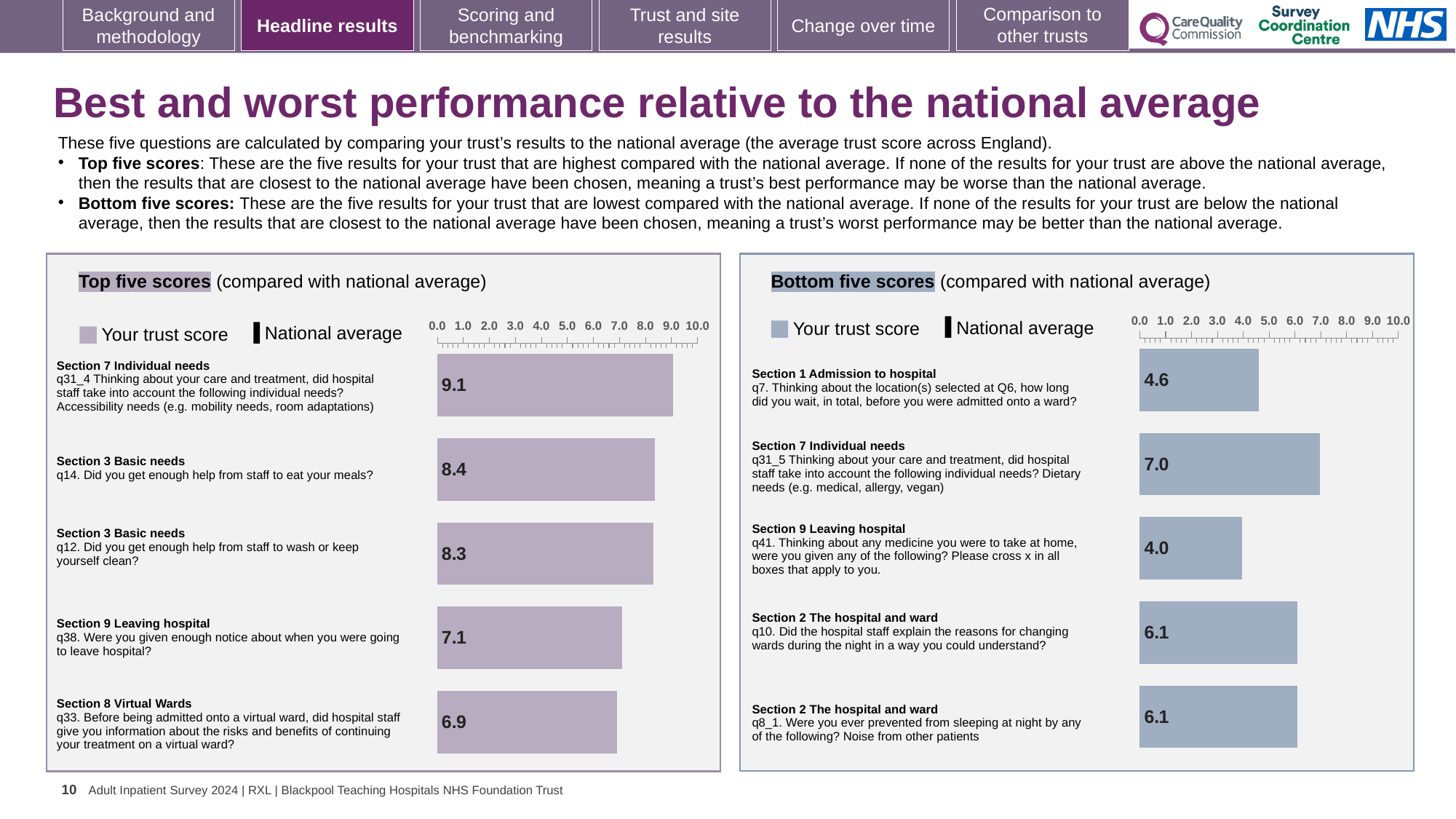
In the 'Top five scores' chart, what is the trust score for q33 (information about the risks and benefits of continuing treatment on a virtual ward)? 6.9 In the 'Top five scores' chart, is the trust score for q38 (enough notice about when you were going to leave hospital) greater or less than 8.0? less In the 'Bottom five scores' chart, what is the difference between the trust score for q31_5 and the trust score for q41? 3.0 In the 'Bottom five scores' chart, which question has the highest trust score? q31_5 (Section 7 Individual needs, dietary needs), 7.0 In the 'Bottom five scores' chart, which question has the lowest trust score? q41 (Section 9 Leaving hospital), 4.0 In the 'Top five scores' chart, what is the difference between the trust score for q31_4 and the trust score for q33? 2.2 In the 'Bottom five scores' chart, which has the larger trust score: q7 (how long did you wait before being admitted onto a ward) or q31_5 (dietary needs)? q31_5 In the 'Top five scores' chart, what is the trust score for q14 (Did you get enough help from staff to eat your meals?)? 8.4 In the 'Top five scores' chart, which question has the highest trust score? q31_4 (Section 7 Individual needs, accessibility needs), 9.1 What type of chart is used for the 'Top five scores' chart? Bar chart How many bars are plotted in the 'Bottom five scores' chart? 5 In the 'Bottom five scores' chart, what is the trust score for q41 (medicine you were to take at home)? 4.0